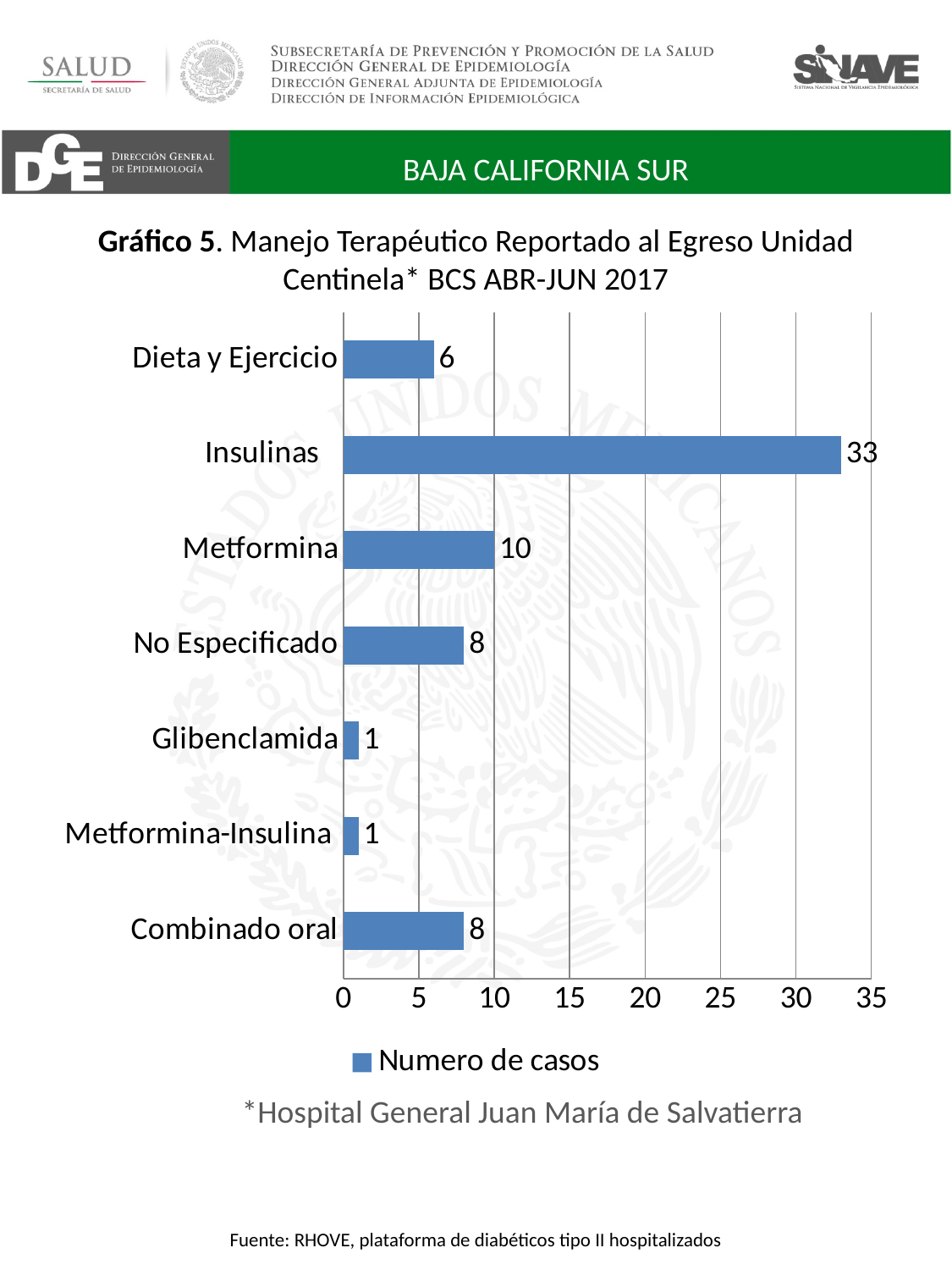
Which category has the highest number of cases? Insulinas What is the legend entry for the series shown? Numero de casos How many categories are shown in the chart? 7 What kind of chart is shown on the slide? bar chart What is the value for Dieta y Ejercicio? 6 Is the value for Insulinas greater or less than 30? greater How many series does the legend list? 1 What is the difference between the values for Insulinas and Metformina? 23 Which is larger, the value for No Especificado or the value for Dieta y Ejercicio? No Especificado What is the value for Insulinas? 33 What is the value for Metformina? 10 What is the value for Combinado oral? 8